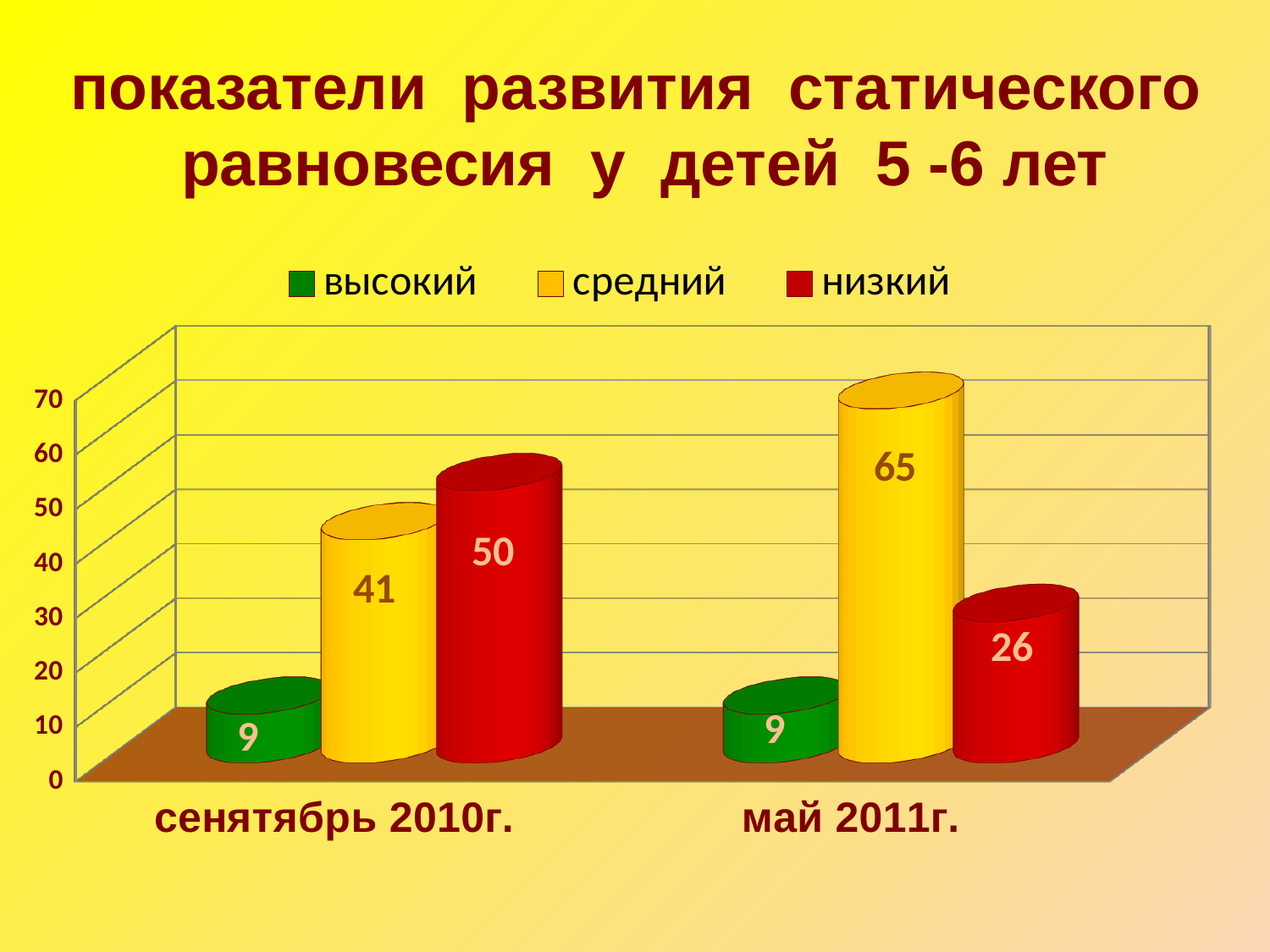
How many categories are shown on the x axis? 2 What is the difference between the "средний" values for май 2011г. and сенятябрь 2010г.? 24 What is the value for "высокий" in май 2011г.? 9 Which is larger: "средний" in сенятябрь 2010г. or "низкий" in сенятябрь 2010г.? низкий Which series has the highest value in сенятябрь 2010г.? низкий What is the difference between the "низкий" values for сенятябрь 2010г. and май 2011г.? 24 What is the value for "средний" in сенятябрь 2010г.? 41 What kind of chart is shown on the slide? bar chart Does the value for "низкий" rise or fall from сенятябрь 2010г. to май 2011г.? fall What is the value for "низкий" in май 2011г.? 26 Which series has the lowest value in май 2011г.? высокий How many series does the legend list? 3